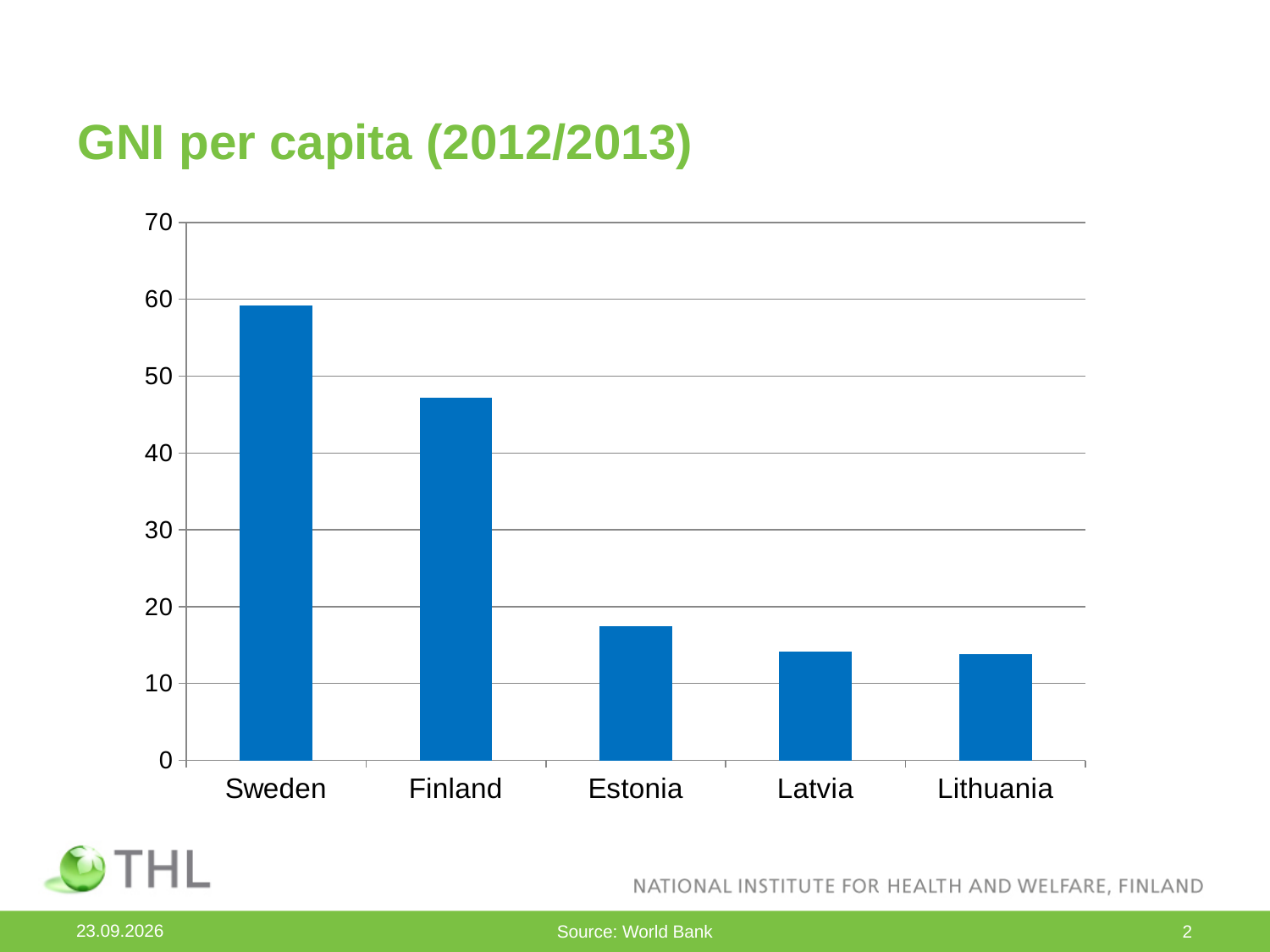
What is the title of the slide containing the chart? GNI per capita (2012/2013) What kind of chart is shown on the slide? bar chart Is the value for Latvia greater or less than 10? greater Is the value for Sweden greater or less than 50? greater Is the value for Estonia greater or less than 20? less How many countries are shown on the x axis of the chart? 5 Which is larger, the value for Sweden or the value for Finland? Sweden Which is larger, the value for Estonia or the value for Lithuania? Estonia What is the highest value shown on the vertical axis of the chart? 70 Which country has the highest GNI per capita in the chart? Sweden Do the values rise or fall from left to right along the x axis? fall